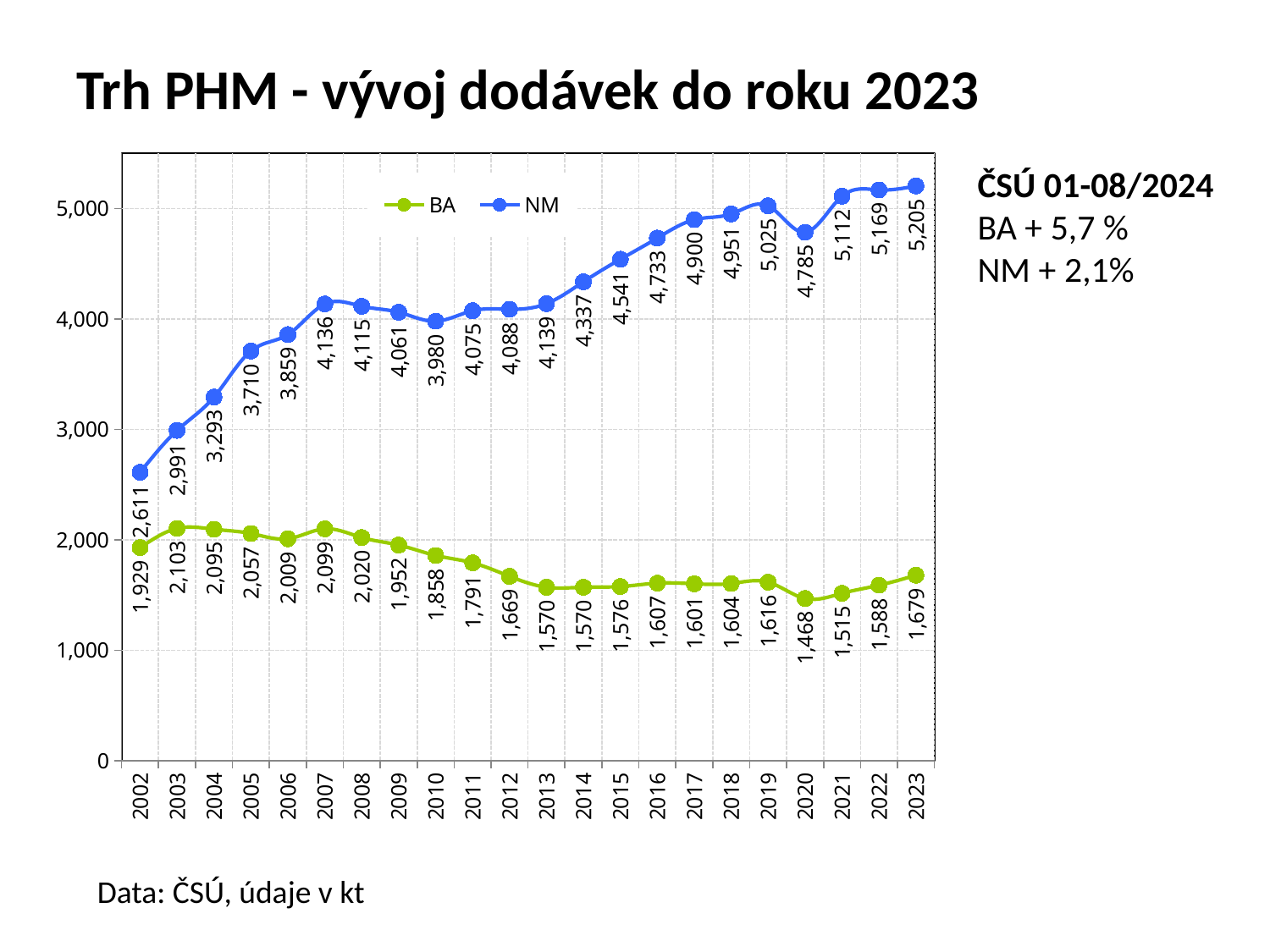
By how much did the NM value fall from 2019 to 2020? 240 In which year is the NM series at its lowest? 2002 In which year does the NM series reach its highest value? 2023 Which series has the larger value in 2015, BA or NM? NM What is the BA value for 2010? 1,858 Does the NM series generally rise or fall from 2002 to 2023? rise In which year is the BA series at its lowest? 2020 How many series does the chart legend list? 2 How many years are plotted on the x axis of the chart? 22 What is the NM value for 2023? 5,205 What type of chart is shown on the slide? line chart What is the difference between the NM and BA values in 2023? 3,526